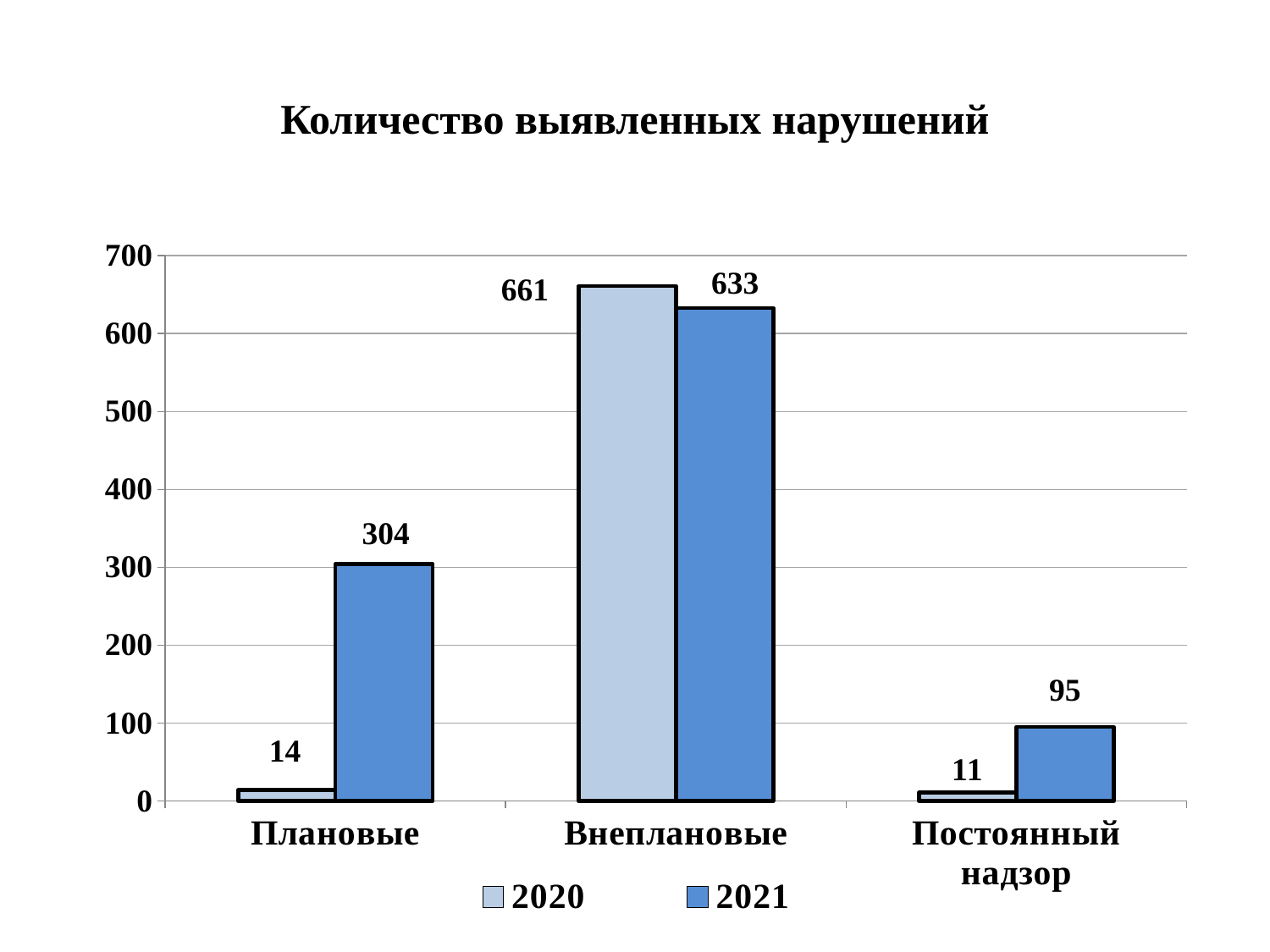
What is the value for Постоянный надзор in 2021? 95 Which category has the lowest value in 2020? Постоянный надзор What is the value for Плановые in 2021? 304 How many series does the legend list? 2 What type of chart is shown on the slide? Bar chart What is the value for Плановые in 2020? 14 What is the difference between the 2020 and 2021 values for Внеплановые? 28 How many categories are shown on the x axis? 3 Which is larger for Внеплановые: the 2020 value or the 2021 value? 2020 What is the value for Внеплановые in 2020? 661 Which category has the highest value in 2021? Внеплановые What is the difference between the 2021 values for Плановые and Постоянный надзор? 209